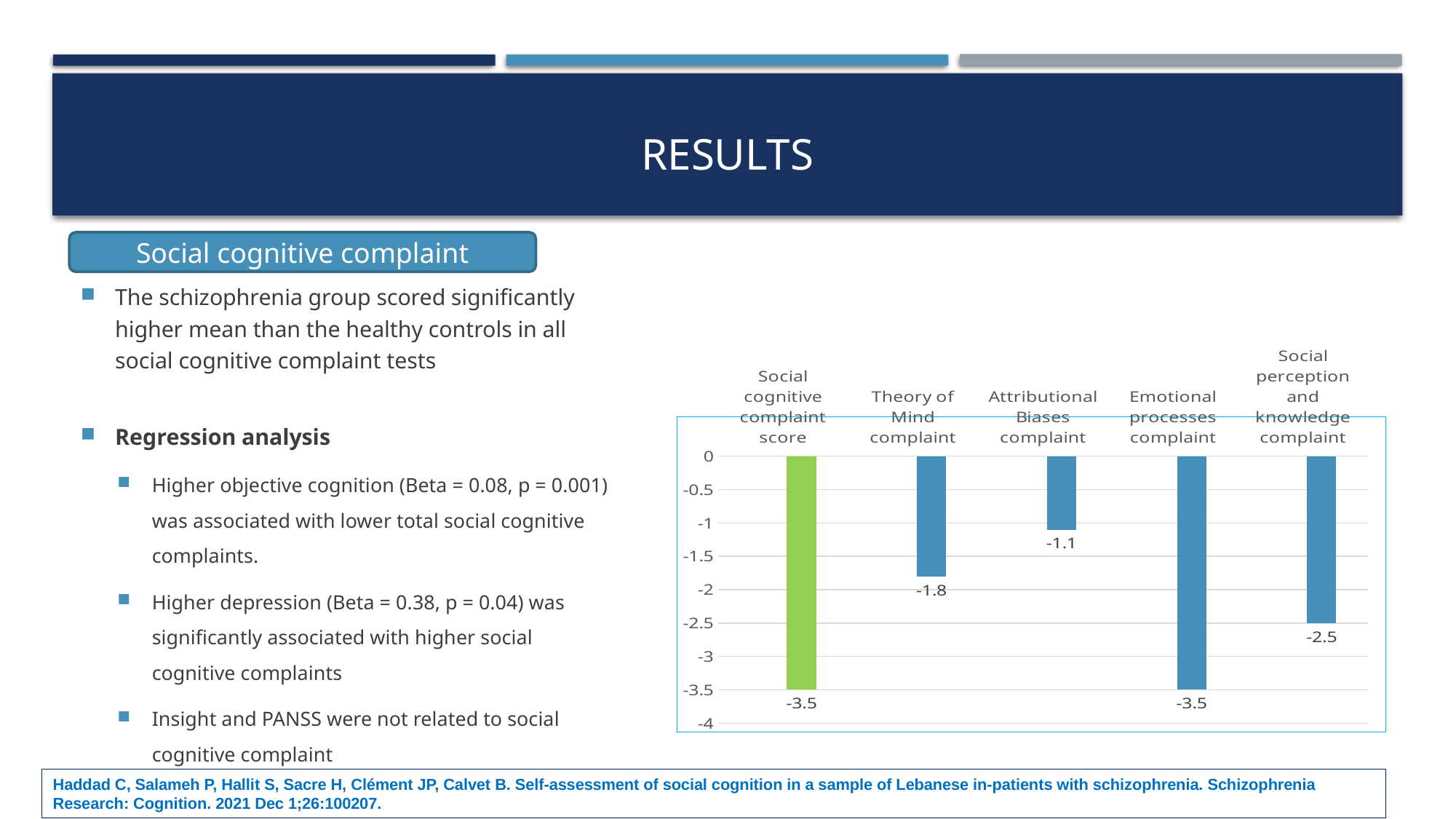
What kind of chart is shown on the slide? Bar chart Which category has the highest value (closest to zero)? Attributional Biases complaint What is the value for Emotional processes complaint? -3.5 What is the value for Social perception and knowledge complaint? -2.5 What is the value for Social cognitive complaint score? -3.5 Which category's bar is coloured green rather than blue? Social cognitive complaint score How many categories are shown in the chart? 5 Which is larger, the value for Theory of Mind complaint or the value for Social perception and knowledge complaint? Theory of Mind complaint What is the difference between the values for Emotional processes complaint and Social perception and knowledge complaint? 1 What is the difference between the values for Theory of Mind complaint and Attributional Biases complaint? 0.7 What is the value for Attributional Biases complaint? -1.1 What is the value for Theory of Mind complaint? -1.8